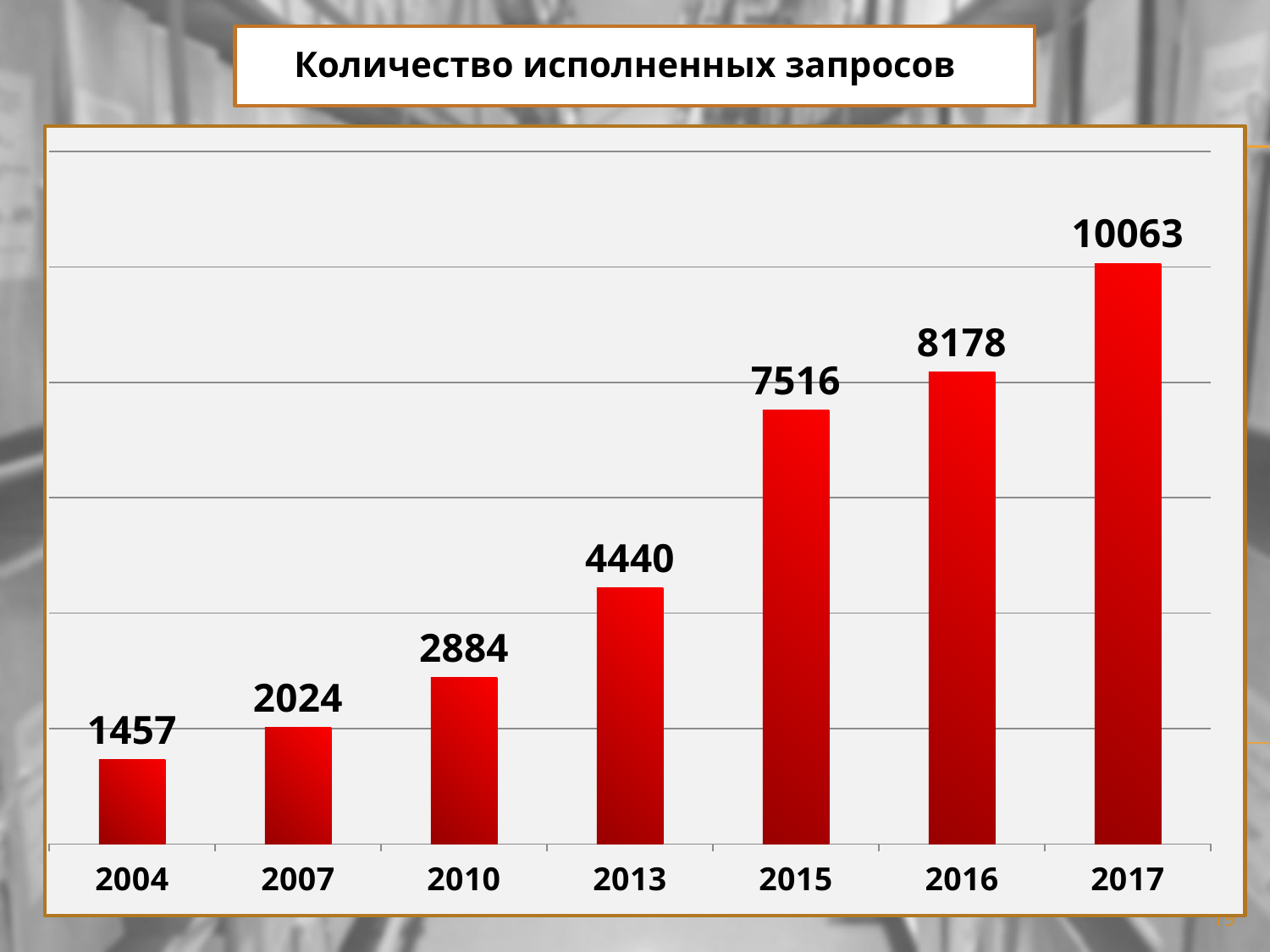
Which year has the highest value? 2017 What kind of chart is this? bar chart Which year has the lowest value? 2004 Which is larger, the value for 2015 or the value for 2013? 2015 Do the values rise or fall from 2004 to 2017? rise What is the value for 2016? 8178 What is the title of the chart? Количество исполненных запросов What is the value for 2004? 1457 How many years are shown on the x axis? 7 What is the value for 2013? 4440 What is the difference between the values for 2017 and 2016? 1885 What is the difference between the values for 2010 and 2007? 860